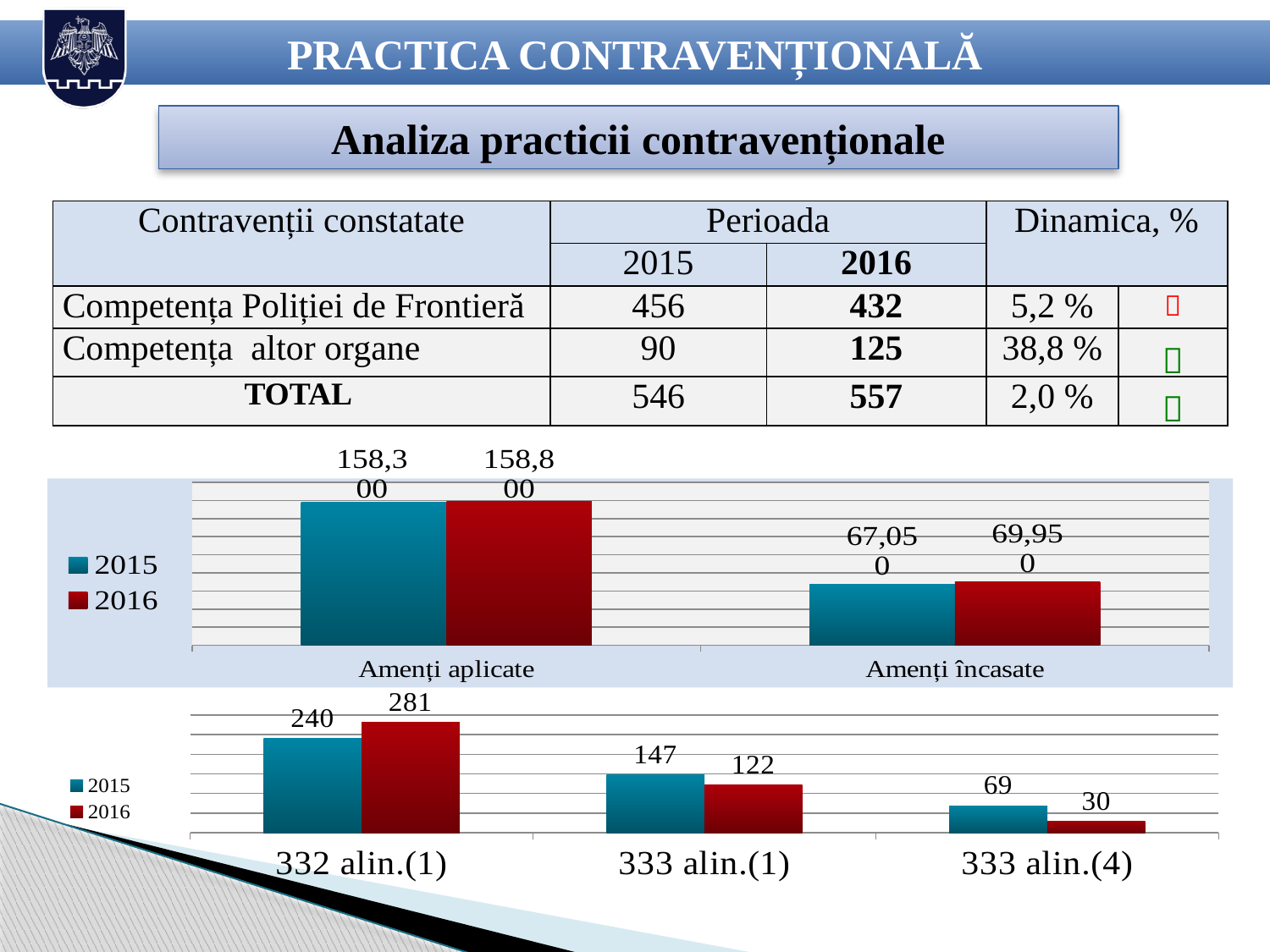
In the lower chart, what is the difference between the 2015 and 2016 values for 333 alin.(4)? 39 In the lower chart, what is the 2016 value for 333 alin.(4)? 30 In the upper chart, which is larger for Amenți încasate: the 2015 value or the 2016 value? 2016 In the lower chart, how many categories are shown on the x axis? 3 In the lower chart, do the 2015 values rise or fall from 332 alin.(1) to 333 alin.(4)? fall In the lower chart, which is larger for 333 alin.(1): the 2015 value or the 2016 value? 2015 In the lower chart, which category has the lowest 2015 value? 333 alin.(4) In the lower chart, what is the 2015 value for 333 alin.(1)? 147 In the lower chart, what is the difference between the 2016 and 2015 values for 332 alin.(1)? 41 In the lower chart, which category has the highest 2016 value? 332 alin.(1) In the lower chart, what is the 2016 value for 332 alin.(1)? 281 How many series does the legend of the upper chart list? 2